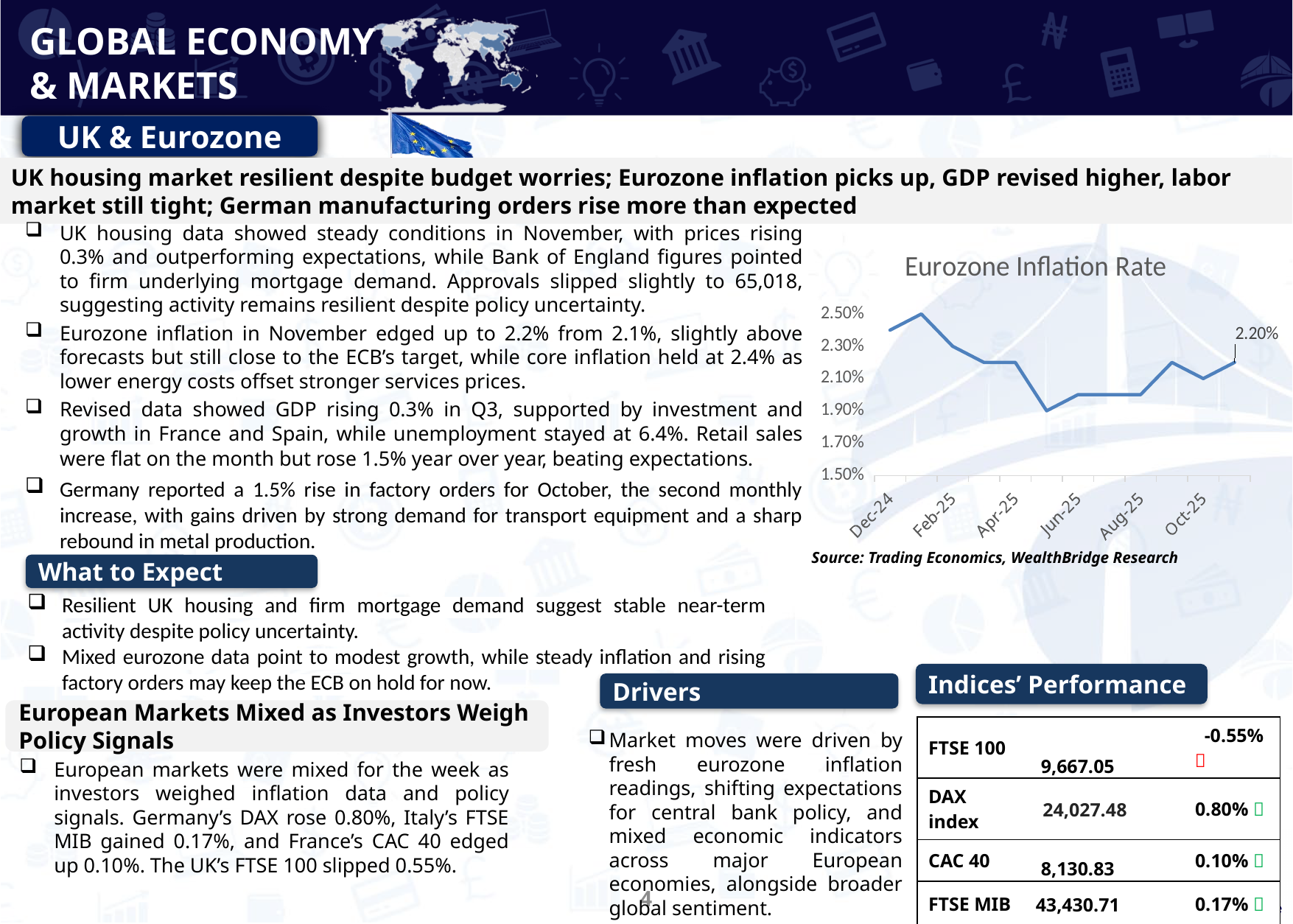
Which is higher on the Eurozone Inflation Rate chart, the value for Dec-24 or the value for Jun-25? Dec-24 Is the Eurozone inflation value for Jun-25 greater or less than 2.10%? less Does the Eurozone inflation rate rise or fall between Dec-24 and Jun-25? fall What kind of chart is the Eurozone Inflation Rate chart? line chart How many month labels are shown on the x axis of the Eurozone Inflation Rate chart? 6 What value is printed as a data label at the end of the Eurozone Inflation Rate line? 2.20% Is the Eurozone inflation value for Aug-25 greater or less than 2.10%? less Is the lowest point on the Eurozone Inflation Rate line greater or less than 2.10%? less What source is cited below the Eurozone Inflation Rate chart? Trading Economics, WealthBridge Research What is the title of the chart on the slide? Eurozone Inflation Rate